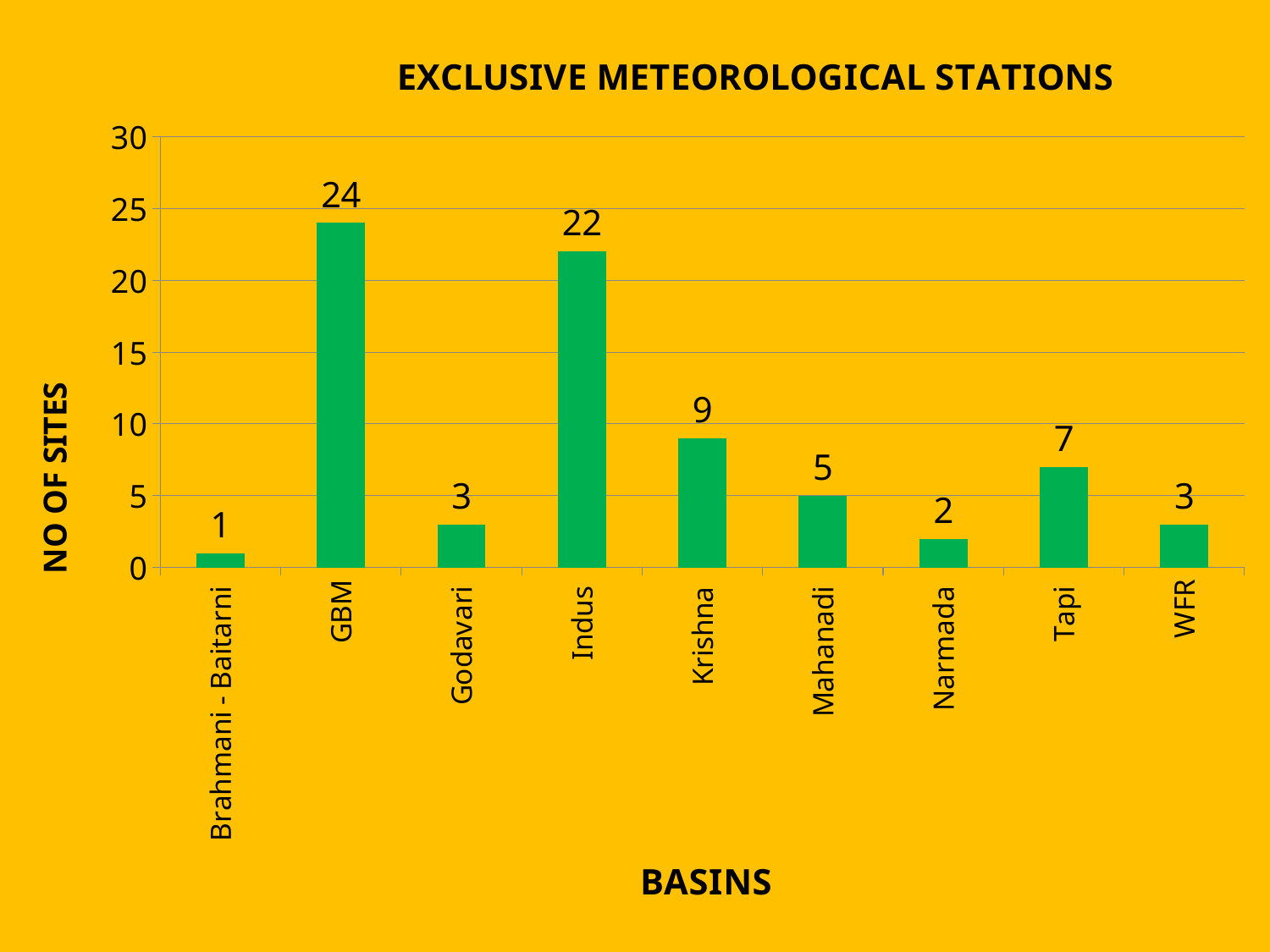
What is the number of sites for the Krishna basin? 9 What kind of chart is shown on the slide? bar chart How many basins are shown on the x axis? 9 What is the title of the chart? EXCLUSIVE METEOROLOGICAL STATIONS Which basin has more sites, Tapi or Mahanadi? Tapi What is the difference in number of sites between Krishna and Mahanadi? 4 Which basin has the highest number of sites? GBM How many exclusive meteorological stations are in the GBM basin? 24 Which basin has the lowest number of sites? Brahmani - Baitarni What is the difference in number of sites between GBM and Indus? 2 Is the value for Indus greater or less than 20? greater What is the number of sites for the Tapi basin? 7